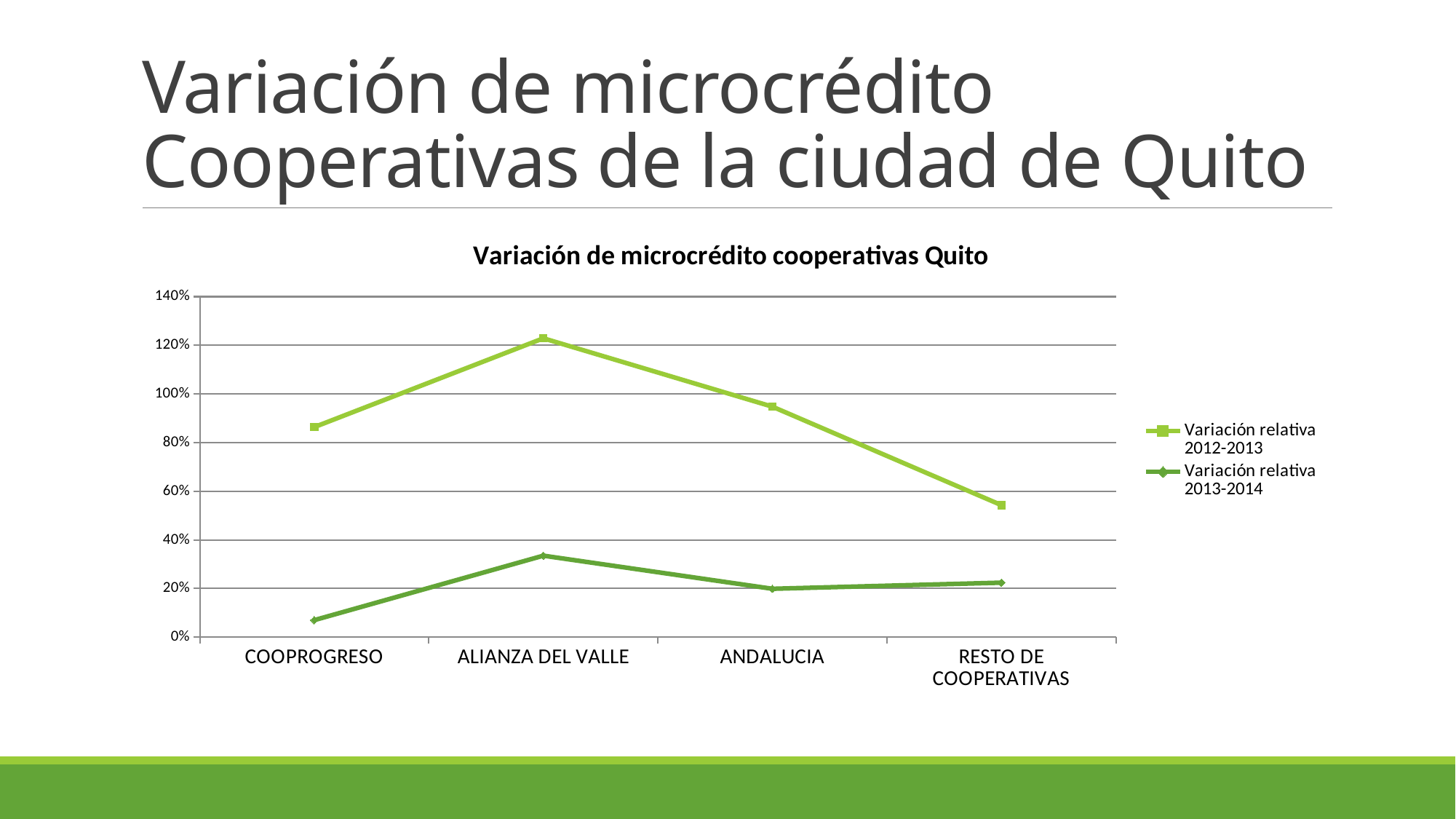
Is the value for ALIANZA DEL VALLE in Variación relativa 2012-2013 greater or less than 100%? greater How many series does the legend list? 2 Which category has the lowest value for Variación relativa 2013-2014? COOPROGRESO How many categories are shown on the x axis? 4 Which category has the highest value for Variación relativa 2013-2014? ALIANZA DEL VALLE Which series is higher at ANDALUCIA, Variación relativa 2012-2013 or Variación relativa 2013-2014? Variación relativa 2012-2013 Is the value for COOPROGRESO in Variación relativa 2013-2014 greater or less than 20%? less What kind of chart is shown on the slide? line chart Which category has the highest value for Variación relativa 2012-2013? ALIANZA DEL VALLE What is the title of the chart? Variación de microcrédito cooperativas Quito Does the Variación relativa 2012-2013 series rise or fall from ALIANZA DEL VALLE to RESTO DE COOPERATIVAS? fall Which category has the lowest value for Variación relativa 2012-2013? RESTO DE COOPERATIVAS